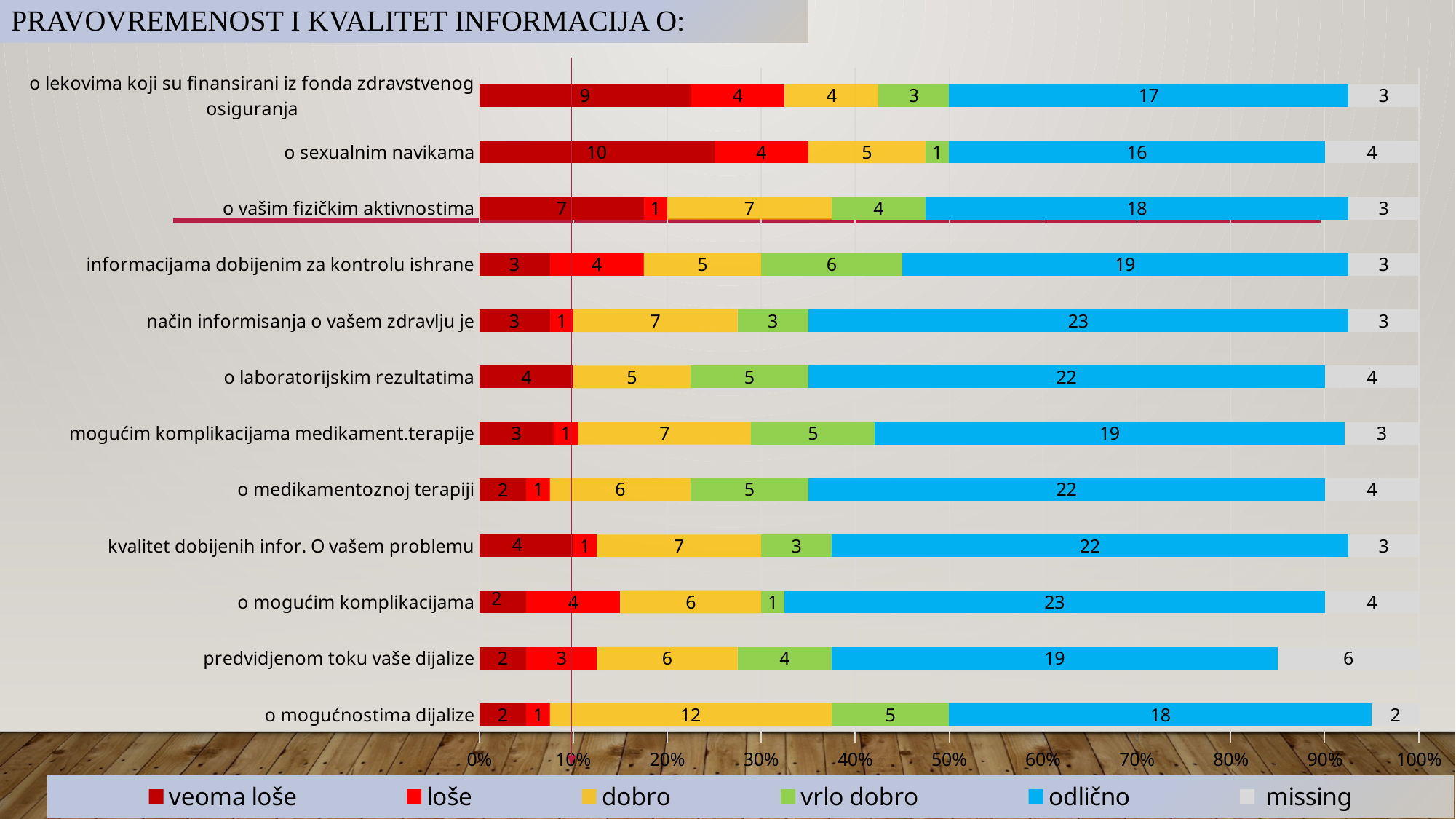
What is the 'veoma loše' value for 'o lekovima koji su finansirani iz fonda zdravstvenog osiguranja'? 9 What is the 'missing' value for 'predvidjenom toku vaše dijalize'? 6 How many series does the legend list? 6 What is the difference between the 'odlično' values for 'način informisanja o vašem zdravlju je' and 'o sexualnim navikama'? 7 How many categories are shown on the chart? 12 Which legend entry is shown in blue? odlično Which is larger: the 'vrlo dobro' value for 'informacijama dobijenim za kontrolu ishrane' or for 'o mogućim komplikacijama'? informacijama dobijenim za kontrolu ishrane Which category has the highest 'veoma loše' value? o sexualnim navikama Which category has the highest 'missing' value? predvidjenom toku vaše dijalize What is the 'dobro' value for 'o mogućnostima dijalize'? 12 What is the 'odlično' value for 'o sexualnim navikama'? 16 What type of chart is shown on the slide? stacked bar chart